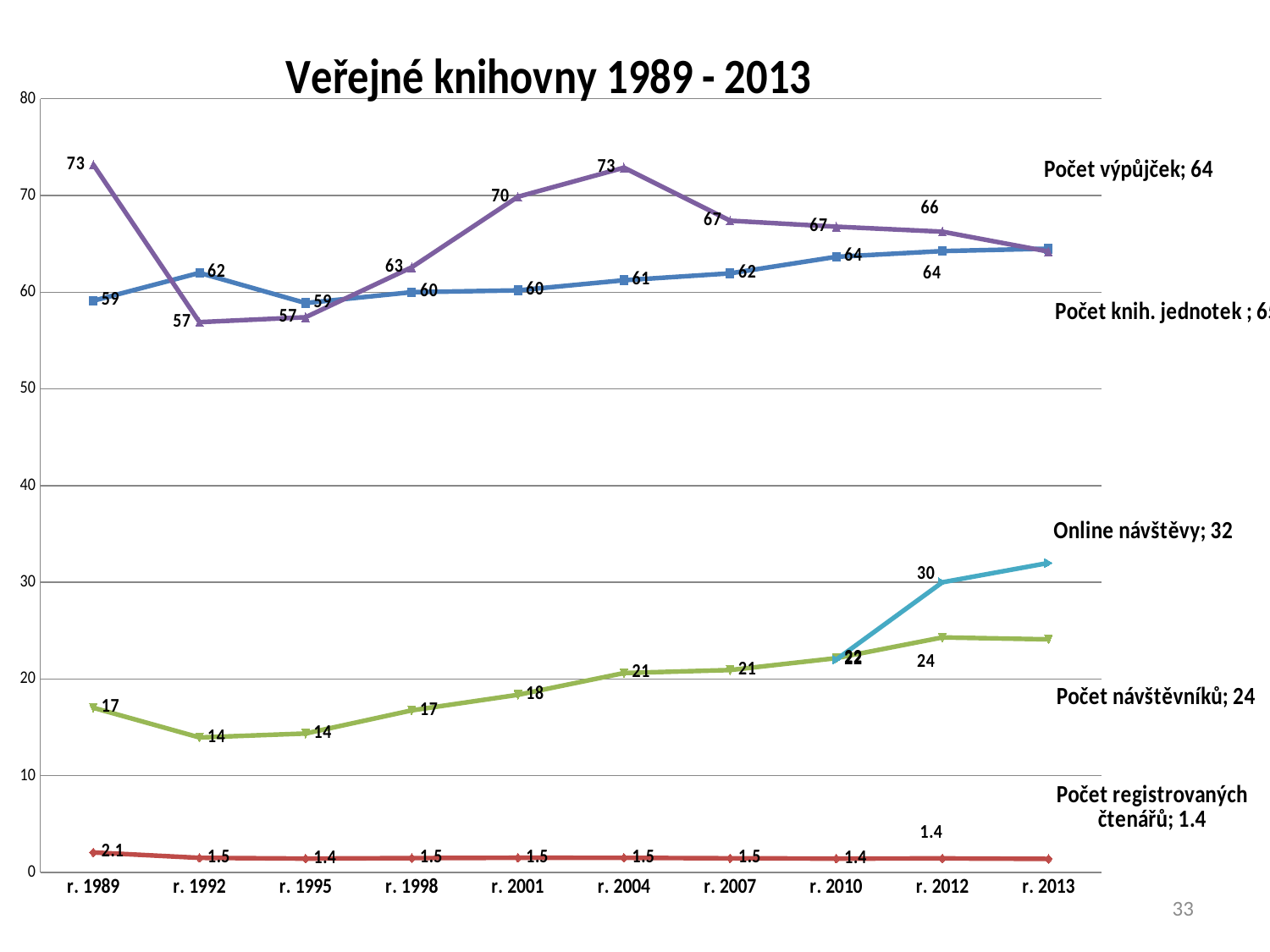
What is the value of Počet registrovaných čtenářů in r. 1989? 2.1 In r. 2001, which is larger: Počet výpůjček or Počet knih. jednotek? Počet výpůjček How many years are shown on the x axis of the chart? 10 What is the value of Online návštěvy in r. 2012? 30 What is the value of Počet návštěvníků in r. 1989? 17 What is the value of Počet výpůjček in r. 2004? 73 In which year is Online návštěvy lowest? r. 2010 How many data series are plotted in the chart? 5 Does Online návštěvy rise or fall from r. 2010 to r. 2013? rise What is the difference between Počet výpůjček in r. 1989 and in r. 1992? 16 What kind of chart is shown on the slide? line chart In which year is Online návštěvy highest? r. 2013